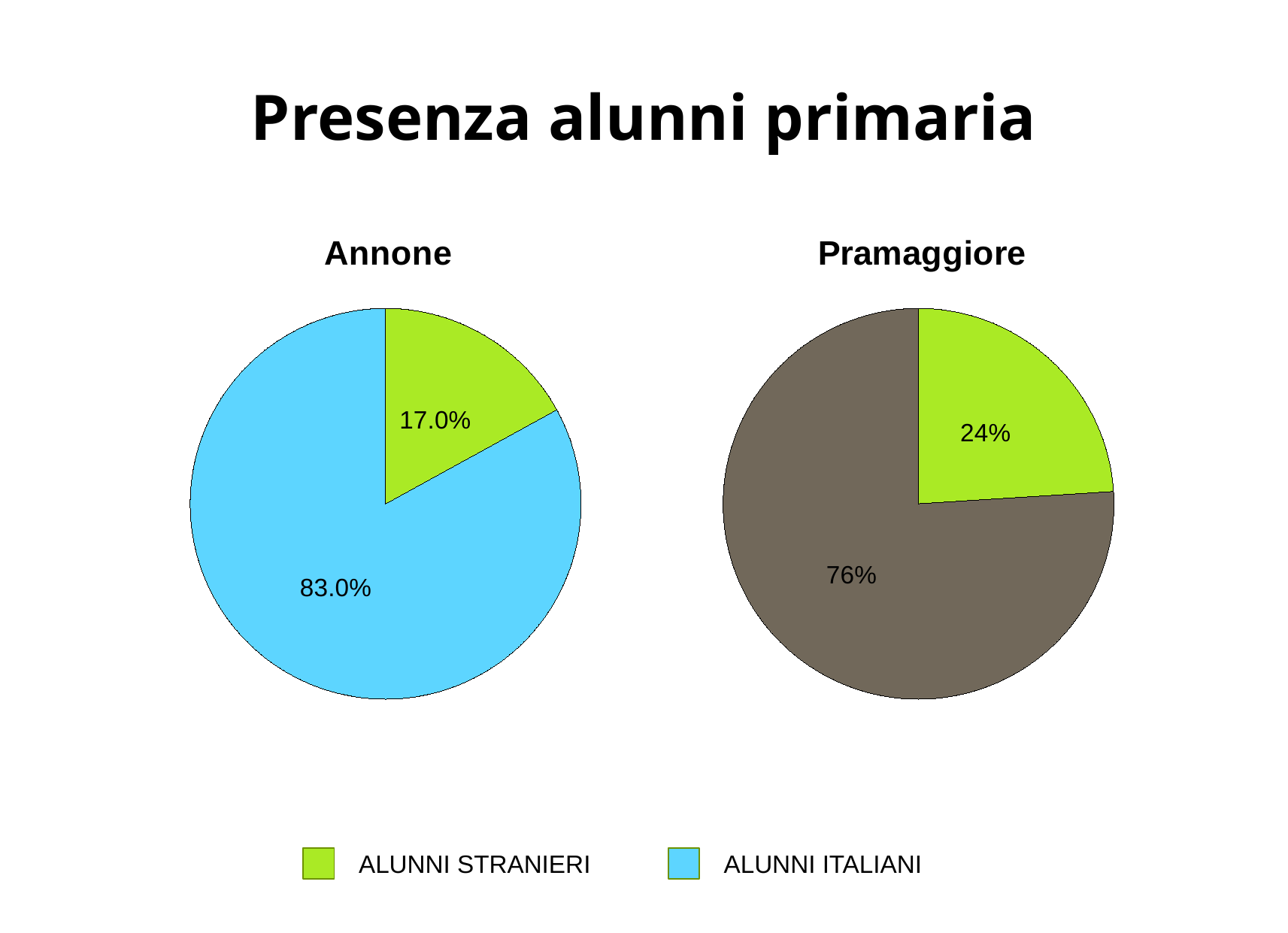
In the Pramaggiore pie chart, what is the difference between the 76% slice and the 24% slice? 52% In the Annone pie chart, what share is shown for ALUNNI STRANIERI? 17.0% How many entries does the legend list? 2 In the Annone pie chart, what is the difference between the ALUNNI ITALIANI share and the ALUNNI STRANIERI share? 66.0% In the Annone pie chart, which slice is the smallest? ALUNNI STRANIERI In the Annone pie chart, which slice is the largest? ALUNNI ITALIANI Which chart shows a larger share for ALUNNI STRANIERI, Annone or Pramaggiore? Pramaggiore How many slices does the Annone pie chart have? 2 What type of chart is used for Annone and Pramaggiore? Pie chart In the Annone pie chart, what share is shown for ALUNNI ITALIANI? 83.0% In the Pramaggiore pie chart, what percentage is printed on the larger, grey slice? 76% In the Pramaggiore pie chart, what share is shown for the green ALUNNI STRANIERI slice? 24%